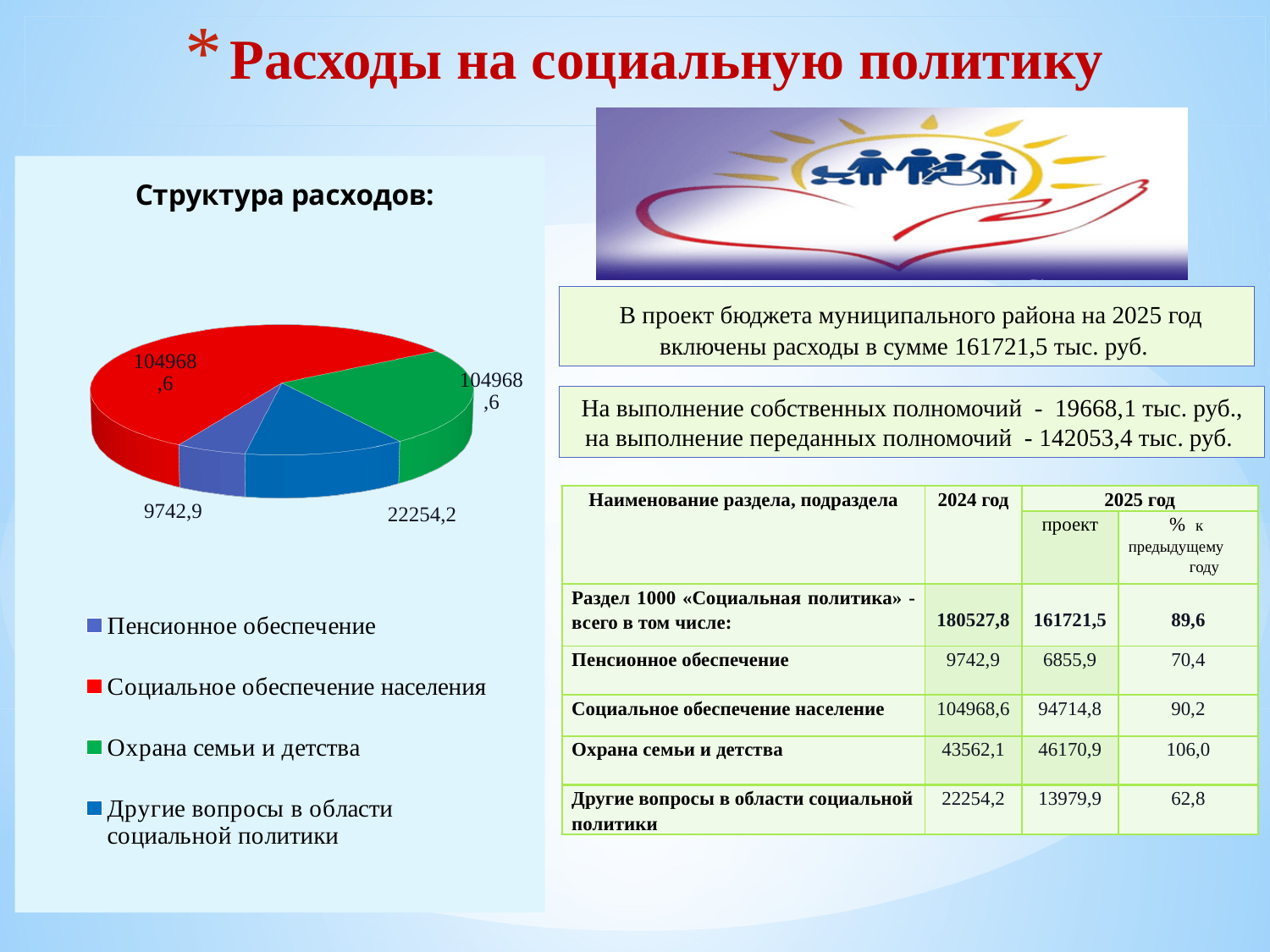
Which category has the smallest slice in the pie chart? Пенсионное обеспечение Which category has the largest slice in the pie chart? Социальное обеспечение населения What is the title shown above the pie chart? Структура расходов: In the pie chart, which is larger: Другие вопросы в области социальной политики or Пенсионное обеспечение? Другие вопросы в области социальной политики How many entries does the legend of the pie chart list? 4 What value is labelled on the red slice (Социальное обеспечение населения) of the pie chart? 104968,6 How many slices does the pie chart have? 4 What is the difference between the labelled values for Другие вопросы в области социальной политики and Пенсионное обеспечение in the pie chart? 12511,3 What colour represents Охрана семьи и детства in the pie chart? green What value is labelled on the pie chart for Другие вопросы в области социальной политики? 22254,2 What value is labelled on the pie chart for Пенсионное обеспечение? 9742,9 What kind of chart is shown under the heading «Структура расходов:»? pie chart